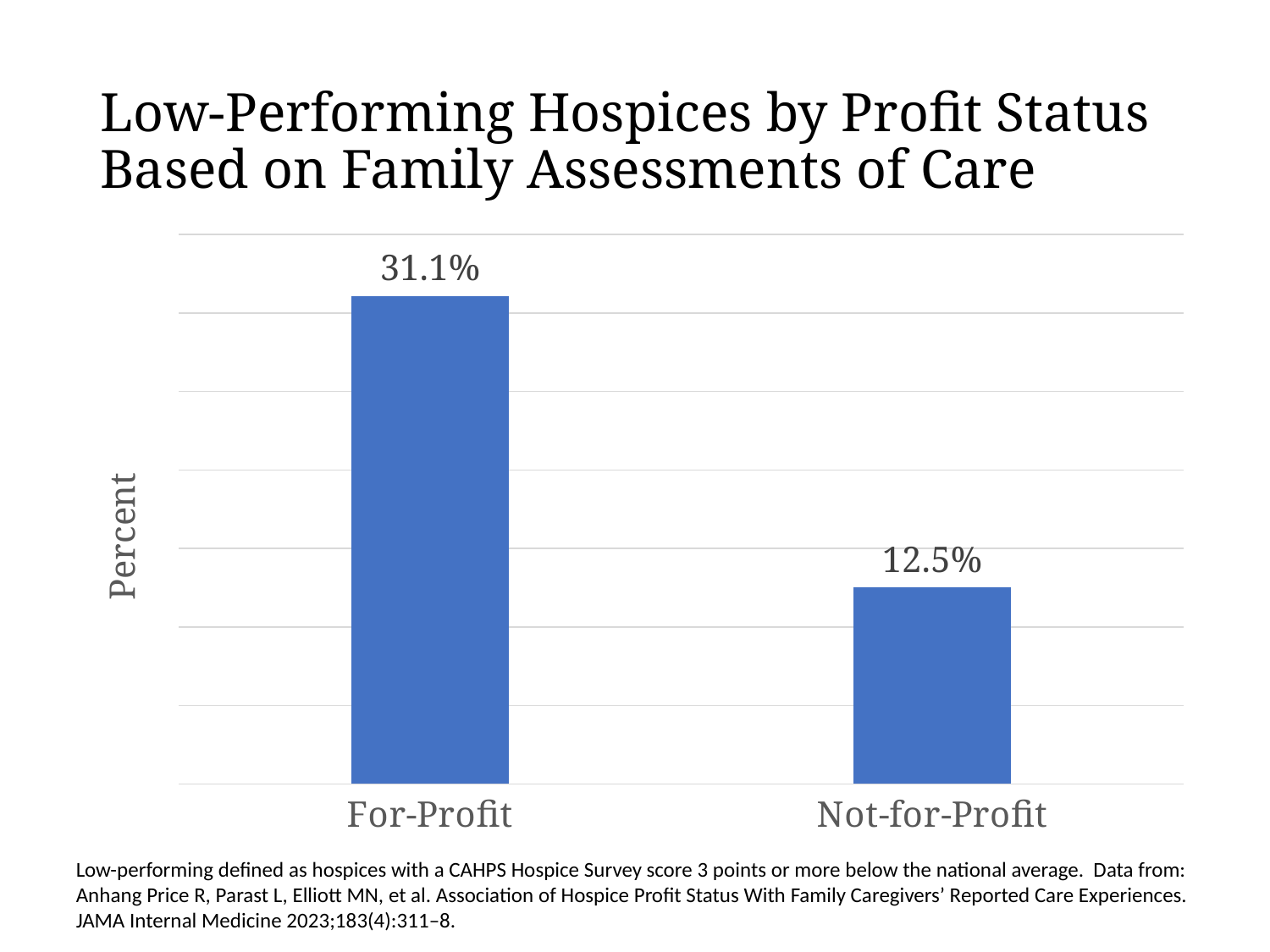
Which profit status has the higher percentage of low-performing hospices? For-Profit What is the value for For-Profit hospices? 31.1% Which profit status has the lower percentage of low-performing hospices? Not-for-Profit What is the title of the chart on the slide? Low-Performing Hospices by Profit Status Based on Family Assessments of Care What is the difference between the For-Profit and Not-for-Profit values? 18.6% Is the value for For-Profit larger or smaller than the value for Not-for-Profit? larger What is the value for Not-for-Profit hospices? 12.5% What is the label on the vertical axis of the chart? Percent How many categories are shown on the chart? 2 What kind of chart is shown on the slide? bar chart